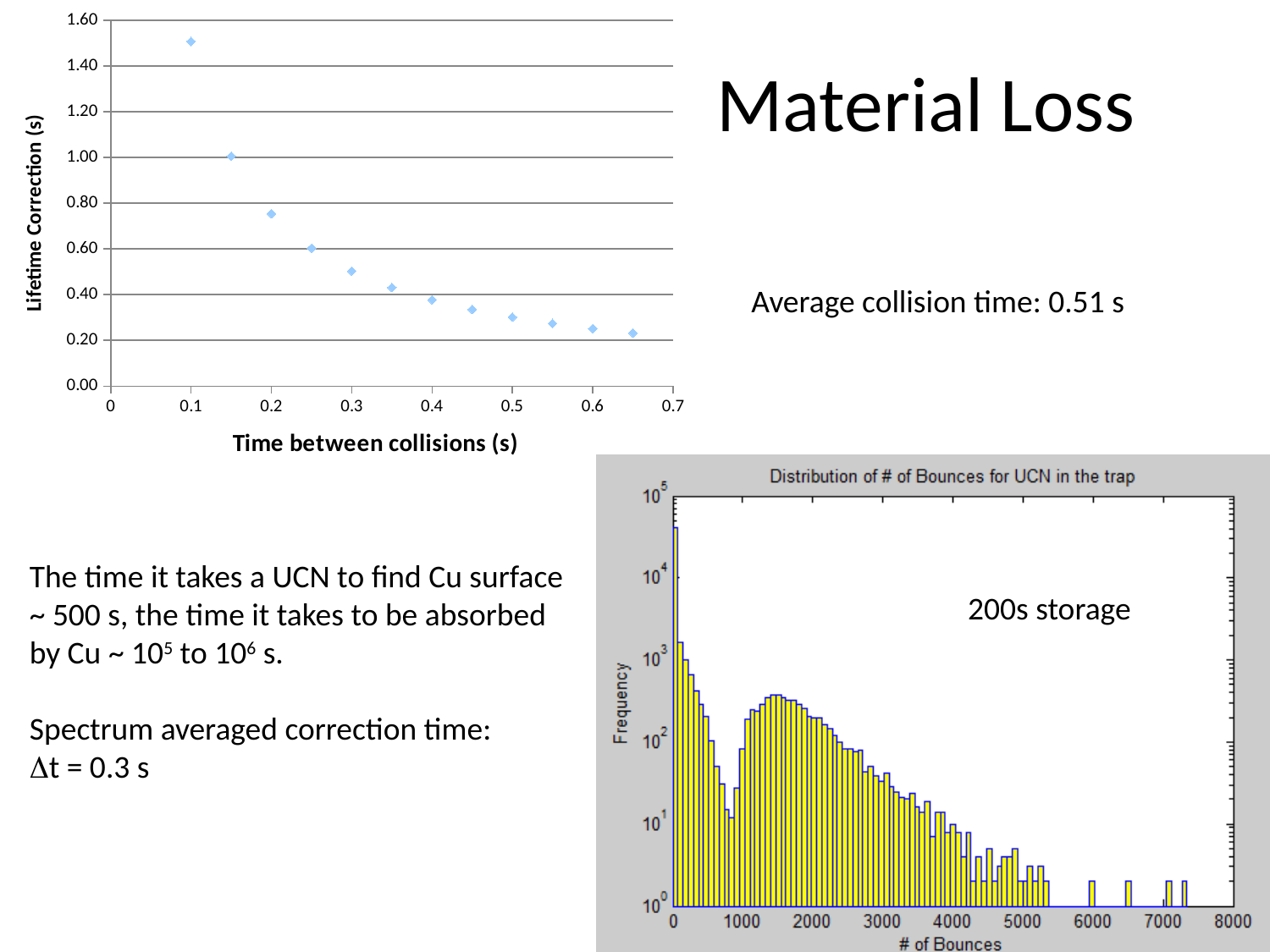
What is the y-axis label of the top-left scatter chart? Lifetime Correction (s) What is the title of the bottom-right chart? Distribution of # of Bounces for UCN in the trap In the top-left scatter chart, is the Lifetime Correction at a time between collisions of 0.1 s greater or less than 1.40? greater What kind of chart is the top-left chart of Lifetime Correction versus Time between collisions? scatter plot In the top-left scatter chart, is the Lifetime Correction at a time between collisions of 0.65 s greater or less than 0.40? less In the bottom-right chart 'Distribution of # of Bounces for UCN in the trap', is the frequency of the first bar near 0 bounces greater or less than 10^4? greater In the top-left scatter chart, do the Lifetime Correction values rise or fall as Time between collisions increases? fall In the top-left scatter chart, which time between collisions has the lowest Lifetime Correction? 0.65 In the top-left scatter chart, how many data points are plotted? 12 In the top-left scatter chart, which has the larger Lifetime Correction: a time between collisions of 0.2 s or 0.5 s? 0.2 s In the top-left scatter chart, which time between collisions has the highest Lifetime Correction? 0.1